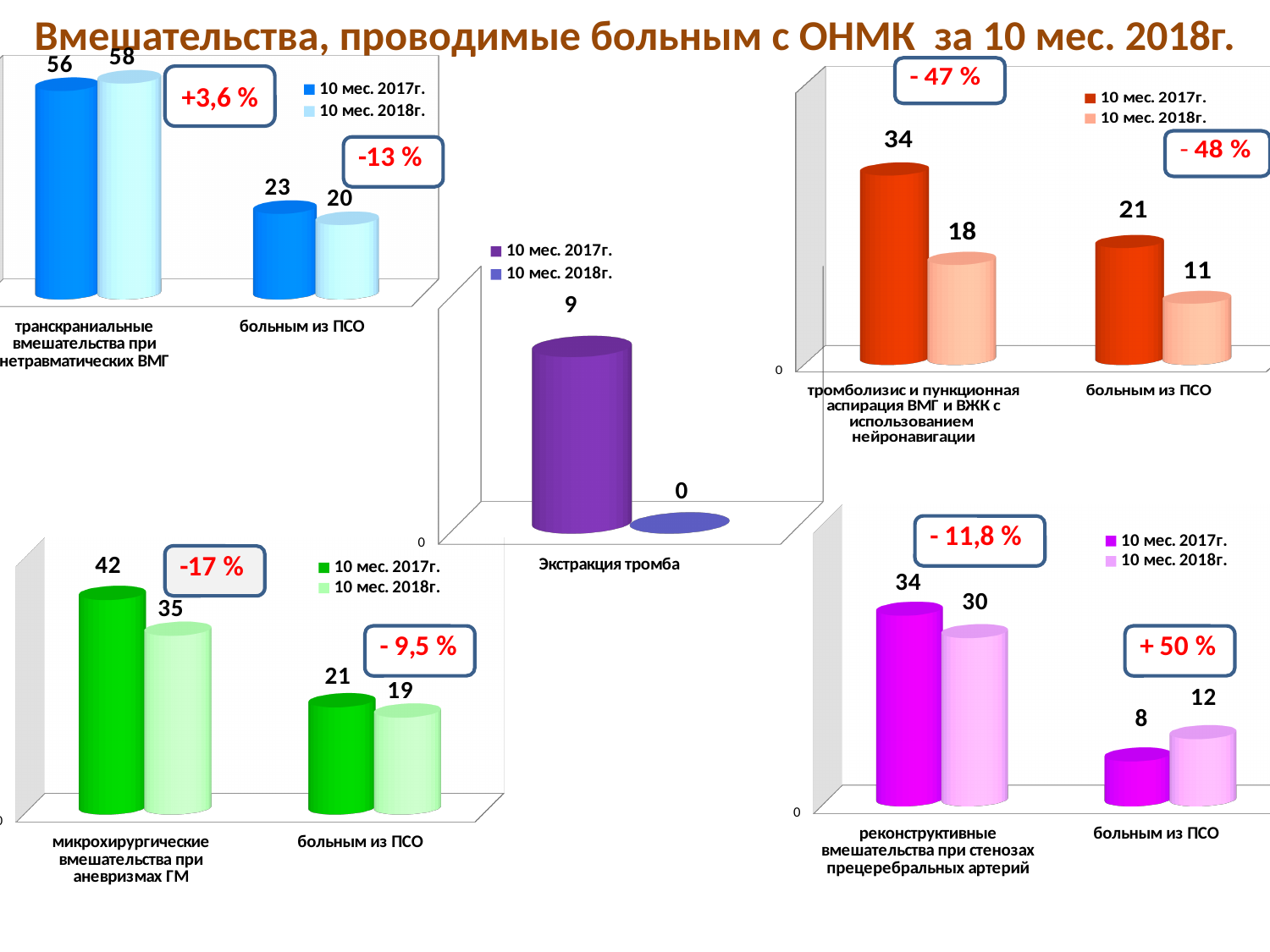
In the bottom-left chart, what is the value for 10 мес. 2018г. for микрохирургические вмешательства при аневризмах ГМ? 35 What kind of chart is the bottom-left chart? bar chart In the bottom-left chart, what is the difference between the 10 мес. 2017г. and 10 мес. 2018г. values for микрохирургические вмешательства при аневризмах ГМ? 7 In the center chart titled Экстракция тромба, what is the value for 10 мес. 2018г.? 0 In the bottom-right chart, which series has the larger value for реконструктивные вмешательства при стенозах прецеребральных артерий, 10 мес. 2017г. or 10 мес. 2018г.? 10 мес. 2017г. In the top-left chart, what is the value for 10 мес. 2018г. for транскраниальные вмешательства при нетравматических ВМГ? 58 In the top-left chart, what is the difference between the 10 мес. 2017г. and 10 мес. 2018г. values for больным из ПСО? 3 In the center chart titled Экстракция тромба, what is the value for 10 мес. 2017г.? 9 In the top-right chart, which series has the larger value for больным из ПСО, 10 мес. 2017г. or 10 мес. 2018г.? 10 мес. 2017г. In the bottom-right chart, what is the value for 10 мес. 2018г. for больным из ПСО? 12 In the top-right chart, what is the value for 10 мес. 2017г. for тромболизис и пункционная аспирация ВМГ и ВЖК с использованием нейронавигации? 34 How many series does the legend of the bottom-right chart list? 2